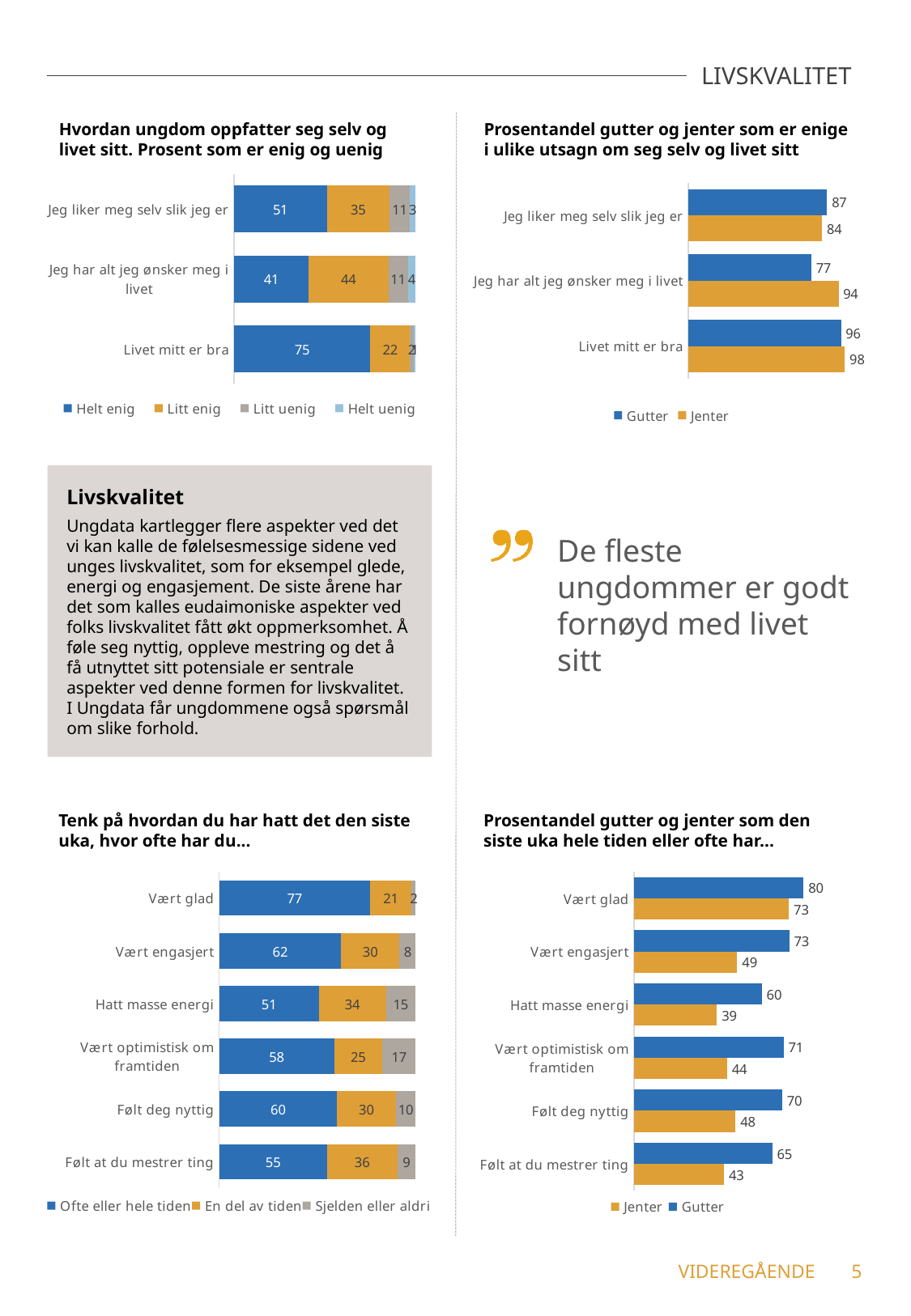
In the bottom-left chart 'Tenk på hvordan du har hatt det den siste uka, hvor ofte har du…', which category has the lowest 'Ofte eller hele tiden' value? Hatt masse energi In the top-left chart 'Hvordan ungdom oppfatter seg selv og livet sitt', what is the 'Helt enig' value for 'Livet mitt er bra'? 75 What kind of chart is the bottom-left chart 'Tenk på hvordan du har hatt det den siste uka, hvor ofte har du…'? Stacked bar chart In the top-left chart 'Hvordan ungdom oppfatter seg selv og livet sitt', what is the 'Litt enig' value for 'Jeg har alt jeg ønsker meg i livet'? 44 How many series does the legend of the top-left chart 'Hvordan ungdom oppfatter seg selv og livet sitt' list? 4 In the bottom-right chart 'Prosentandel gutter og jenter som den siste uka hele tiden eller ofte har…', what is the value for Jenter on 'Hatt masse energi'? 39 How many categories are shown in the bottom-left chart 'Tenk på hvordan du har hatt det den siste uka, hvor ofte har du…'? 6 In the bottom-left chart 'Tenk på hvordan du har hatt det den siste uka, hvor ofte har du…', what is the 'Sjelden eller aldri' value for 'Vært optimistisk om framtiden'? 17 In the bottom-right chart 'Prosentandel gutter og jenter som den siste uka hele tiden eller ofte har…', which is larger for 'Vært engasjert': Gutter or Jenter? Gutter In the top-right chart 'Prosentandel gutter og jenter som er enige i ulike utsagn om seg selv og livet sitt', what is the difference between Jenter and Gutter for 'Jeg har alt jeg ønsker meg i livet'? 17 In the top-right chart 'Prosentandel gutter og jenter som er enige i ulike utsagn om seg selv og livet sitt', which statement has the highest value for Gutter? Livet mitt er bra In the top-right chart 'Prosentandel gutter og jenter som er enige i ulike utsagn om seg selv og livet sitt', what is the value for Jenter on 'Jeg har alt jeg ønsker meg i livet'? 94